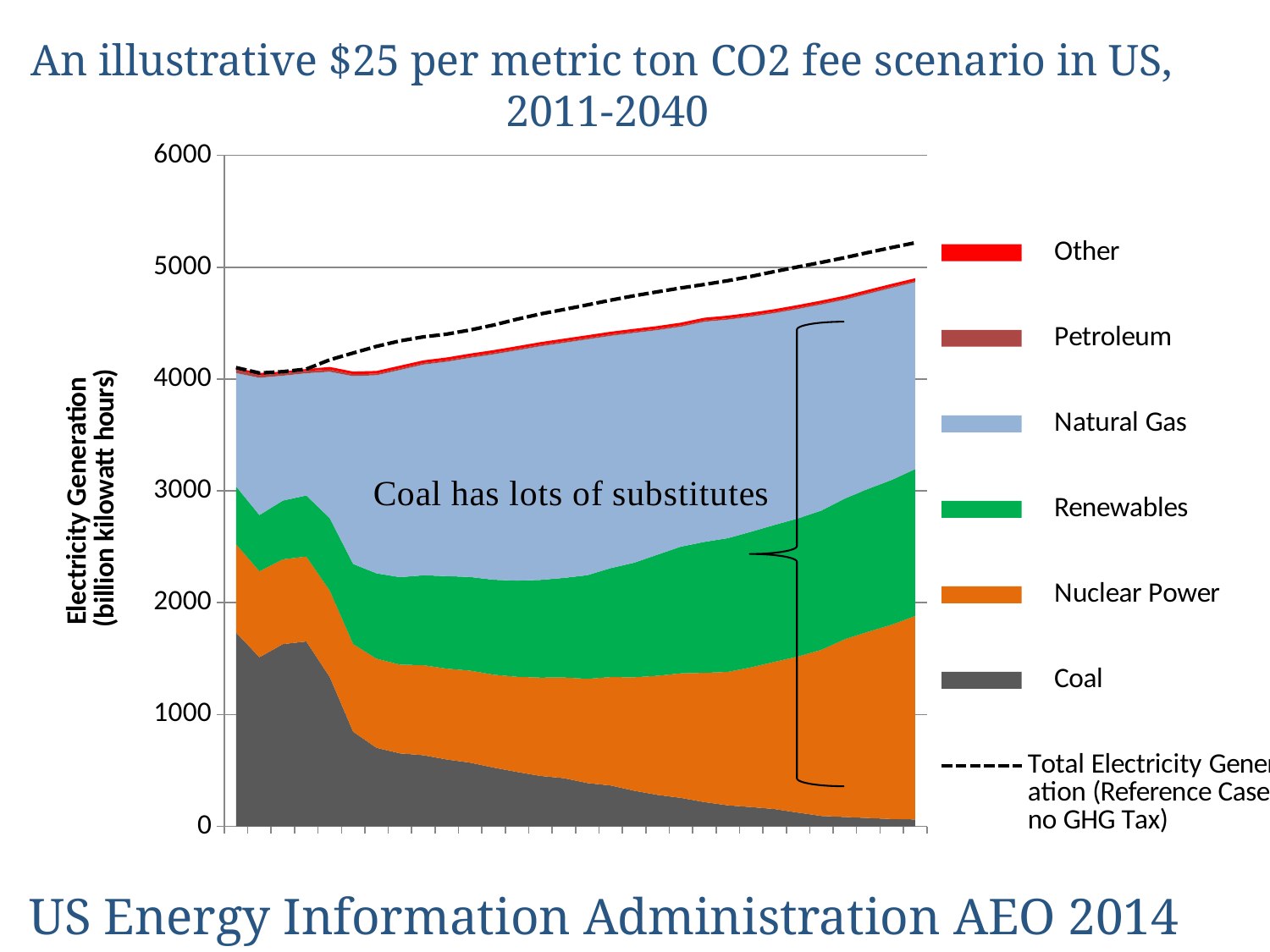
At the right end of the chart, which band is larger: Natural Gas or Coal? Natural Gas Is the Coal value at the left end of the chart greater or less than 1000? greater What is the label of the vertical axis? Electricity Generation (billion kilowatt hours) Does the Renewables area rise or fall from left to right along the x axis? rise Which series is plotted as a dashed line? Total Electricity Generation (Reference Case, no GHG Tax) Is the value of the dashed Total Electricity Generation line at the right end of the chart greater or less than 5000? greater What kind of chart is shown on the slide? stacked area chart Does the Coal area rise or fall from left to right along the x axis? fall Does the dashed Total Electricity Generation line rise or fall from left to right? rise How many series does the legend list? 7 Is the Coal value at the right end of the chart greater or less than 1000? less